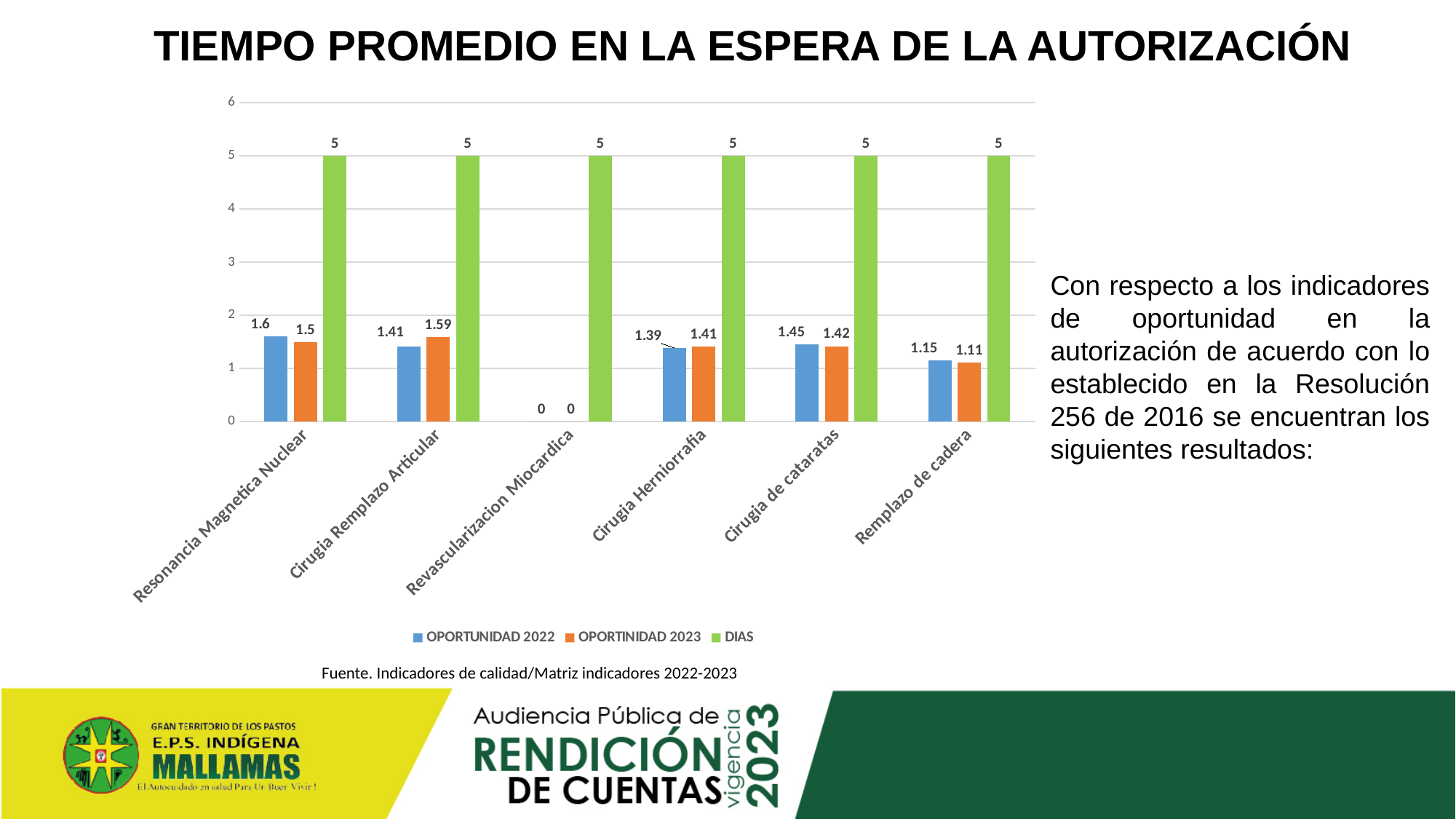
Which category has the lowest OPORTUNIDAD 2022 value? Revascularizacion Miocardica What is the DIAS value for Cirugia de cataratas? 5 What is the difference between the OPORTUNIDAD 2022 and OPORTINIDAD 2023 values for Cirugia Remplazo Articular? 0.18 What kind of chart is shown on the slide? bar chart What is the OPORTUNIDAD 2022 value for Remplazo de cadera? 1.15 Which is larger for Cirugia de cataratas: the OPORTUNIDAD 2022 value or the OPORTINIDAD 2023 value? OPORTUNIDAD 2022 How many series does the legend list? 3 What is the OPORTINIDAD 2023 value for Cirugia Remplazo Articular? 1.59 What is the OPORTUNIDAD 2022 value for Resonancia Magnetica Nuclear? 1.6 Which category has the highest OPORTINIDAD 2023 value? Cirugia Remplazo Articular How many categories are shown on the x axis? 6 Is the DIAS value for Remplazo de cadera greater or less than 4? greater